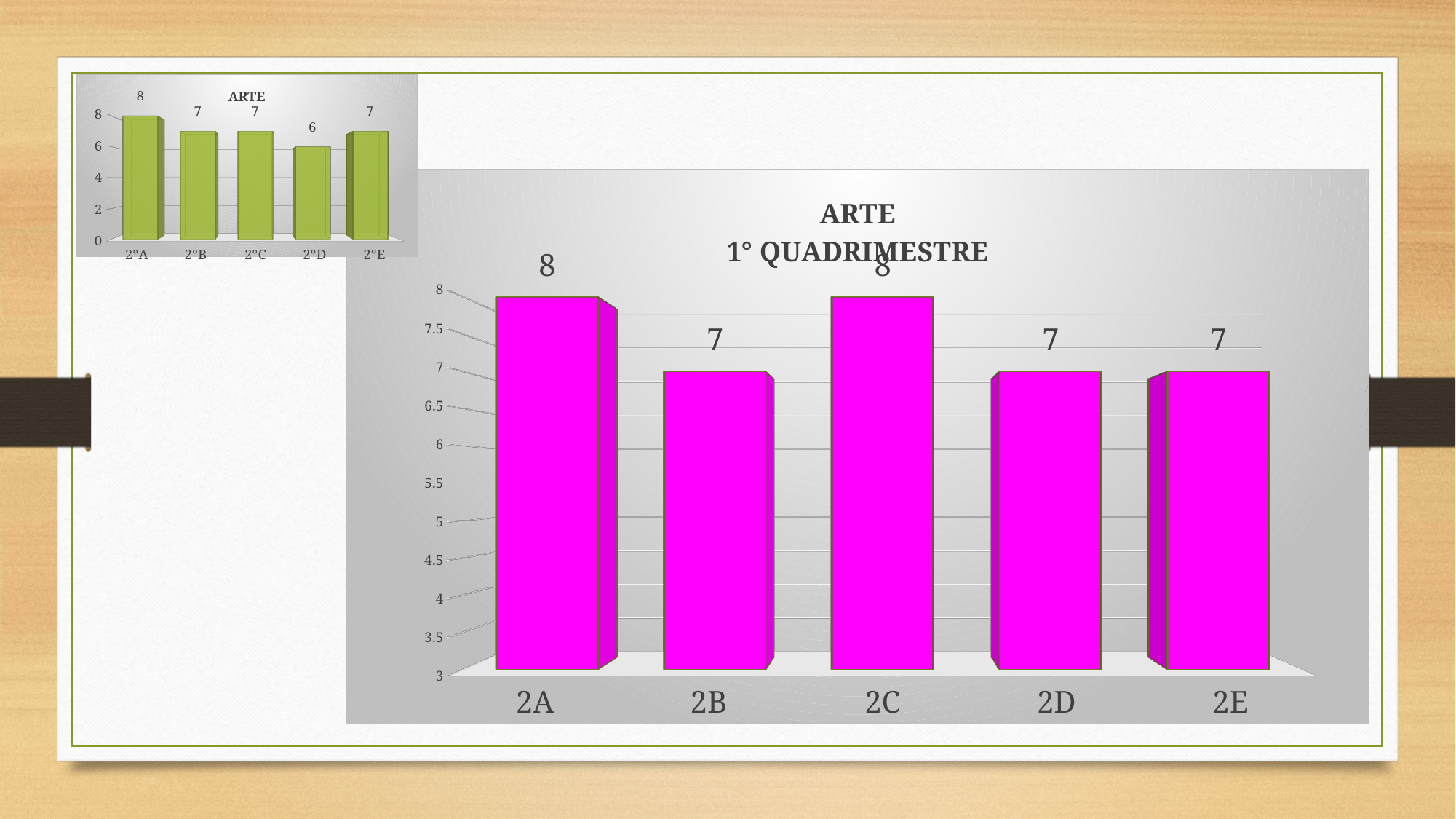
In the small ARTE chart at the top left, which category has the lowest value? 2°D In the ARTE 1° QUADRIMESTRE chart, how many categories are shown on the x axis? 5 In the small ARTE chart at the top left, what is the value for 2°D? 6 In the ARTE 1° QUADRIMESTRE chart, what is the difference between the values for 2A and 2D? 1 In the small ARTE chart at the top left, which category has the highest value? 2°A In the ARTE 1° QUADRIMESTRE chart, which is larger, the value for 2C or the value for 2E? 2C In the small ARTE chart at the top left, what is the difference between the values for 2°A and 2°D? 2 In the ARTE 1° QUADRIMESTRE chart, what is the value for 2B? 7 What colour are the bars in the ARTE 1° QUADRIMESTRE chart? magenta In the ARTE 1° QUADRIMESTRE chart, what is the value for 2C? 8 In the ARTE 1° QUADRIMESTRE chart, what is the value for 2A? 8 What kind of chart is the ARTE 1° QUADRIMESTRE chart? bar chart